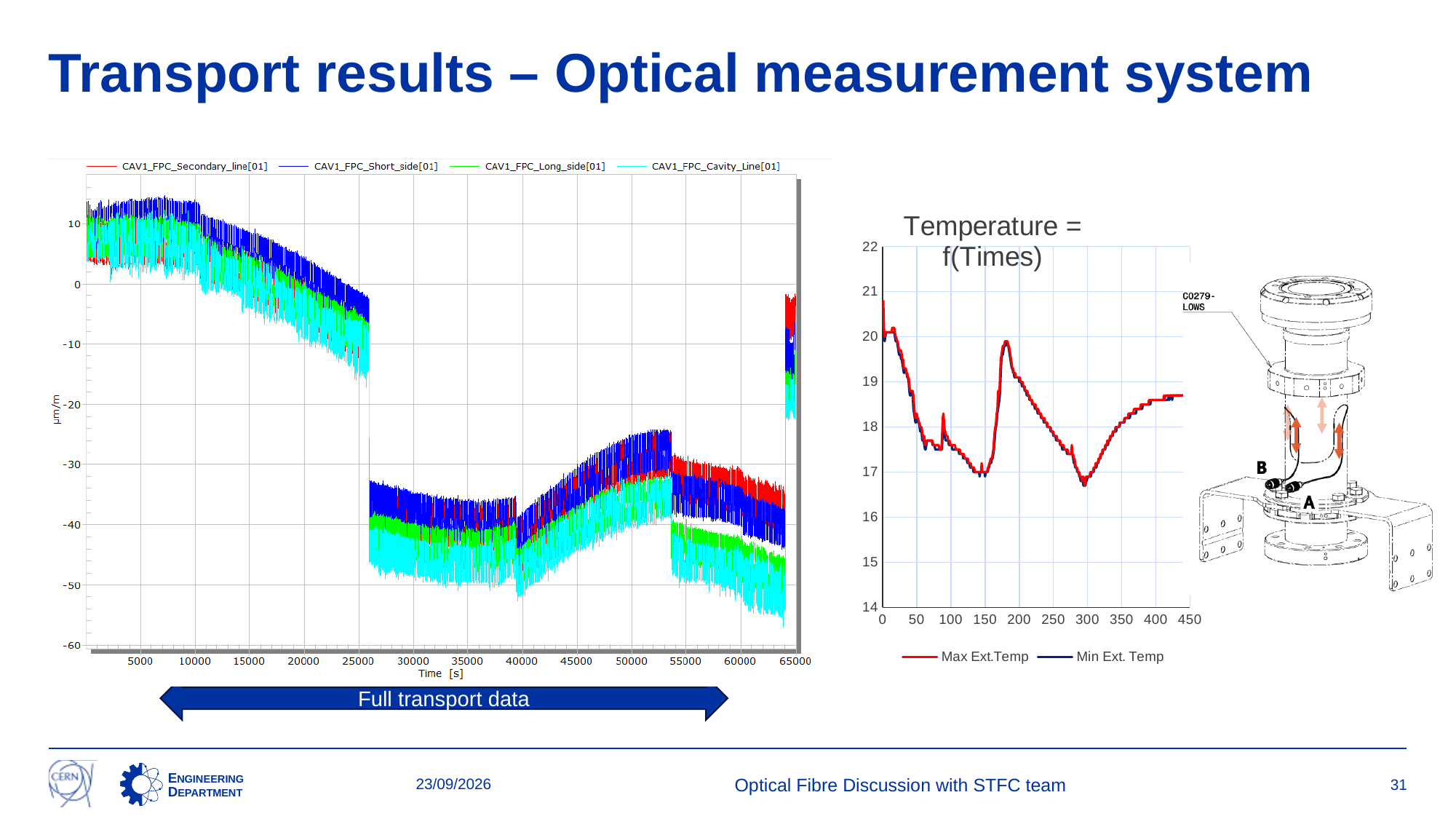
How many series does the legend of the 'Temperature = f(Times)' chart list? 2 What kind of chart is the chart on the left of the slide? line chart On the left chart, is the value of CAV1_FPC_Short_side[01] at around 5000 s greater or less than 0? greater On the left chart, what is the label of the x axis? Time [s] How many series does the legend of the left chart list? 4 What is the title of the chart on the right of the slide? Temperature = f(Times) On the 'Temperature = f(Times)' chart, is the value of Max Ext.Temp at time 300 greater or less than 18? less On the 'Temperature = f(Times)' chart, is the value of Max Ext.Temp at time 0 greater or less than 20? greater On the left chart, which series has the lowest values between 55000 s and 65000 s? CAV1_FPC_Cavity_Line[01] On the left chart, what is the label of the y axis? µm/m On the left chart, do the values rise or fall along the x axis between 10000 s and 25000 s? fall